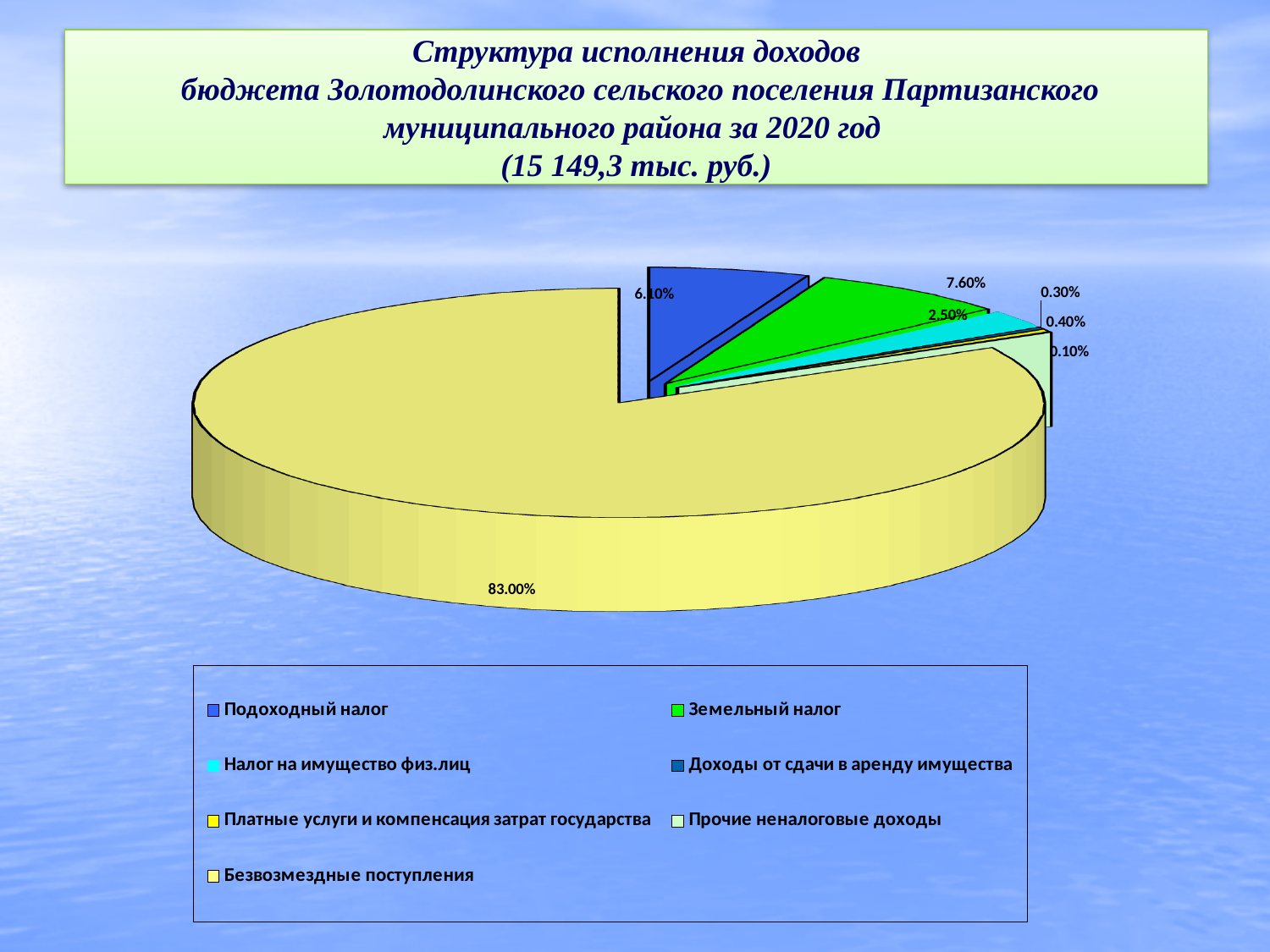
Which is larger, Земельный налог or Подоходный налог? Земельный налог Which colour represents Подоходный налог in the legend? Blue What is the value shown for Земельный налог? 7.60% What is the value shown for Подоходный налог? 6.10% How many categories does the legend list? 7 Which category has the smallest slice of the pie? Прочие неналоговые доходы What kind of chart is shown on the slide? Pie chart What share of the pie does Безвозмездные поступления account for? 83.00% Which category has the largest slice of the pie? Безвозмездные поступления What is the value shown for Налог на имущество физ.лиц? 2.50% What total amount in thousand rubles is given in the chart title? 15 149,3 тыс. руб. What is the difference between the shares of Земельный налог and Подоходный налог? 1.50%